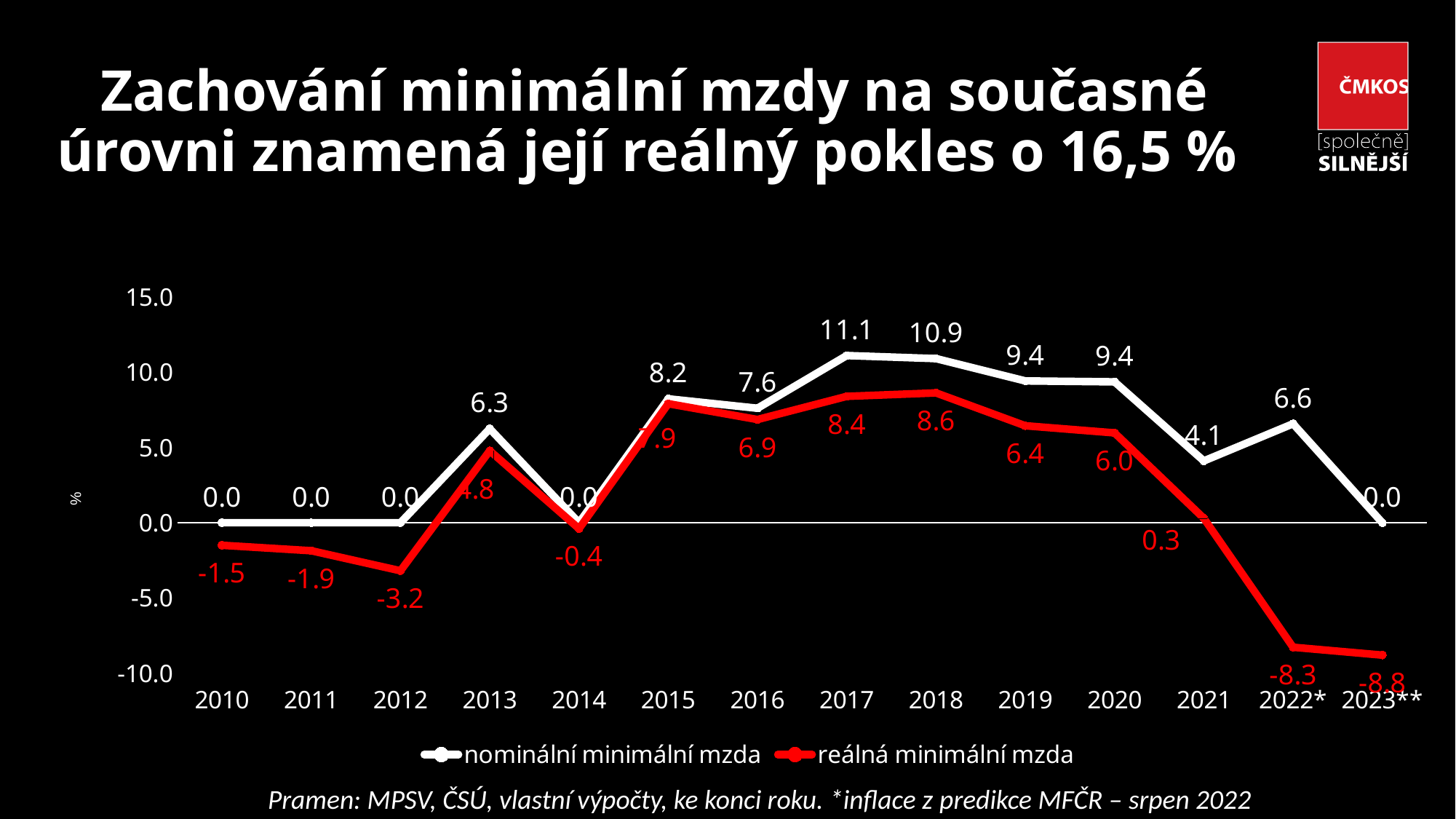
What type of chart is shown on the slide? line chart How many series does the legend list? 2 In which year is nominální minimální mzda highest? 2017 Which is larger in 2021: nominální minimální mzda or reálná minimální mzda? nominální minimální mzda What is the value of reálná minimální mzda in 2023**? -8.8 In which year is reálná minimální mzda lowest? 2023** What is the difference between nominální minimální mzda and reálná minimální mzda in 2017? 2.7 Does reálná minimální mzda rise or fall from 2020 to 2023**? fall How many years are plotted along the x axis? 14 What is the value of nominální minimální mzda in 2017? 11.1 What is the value of reálná minimální mzda in 2012? -3.2